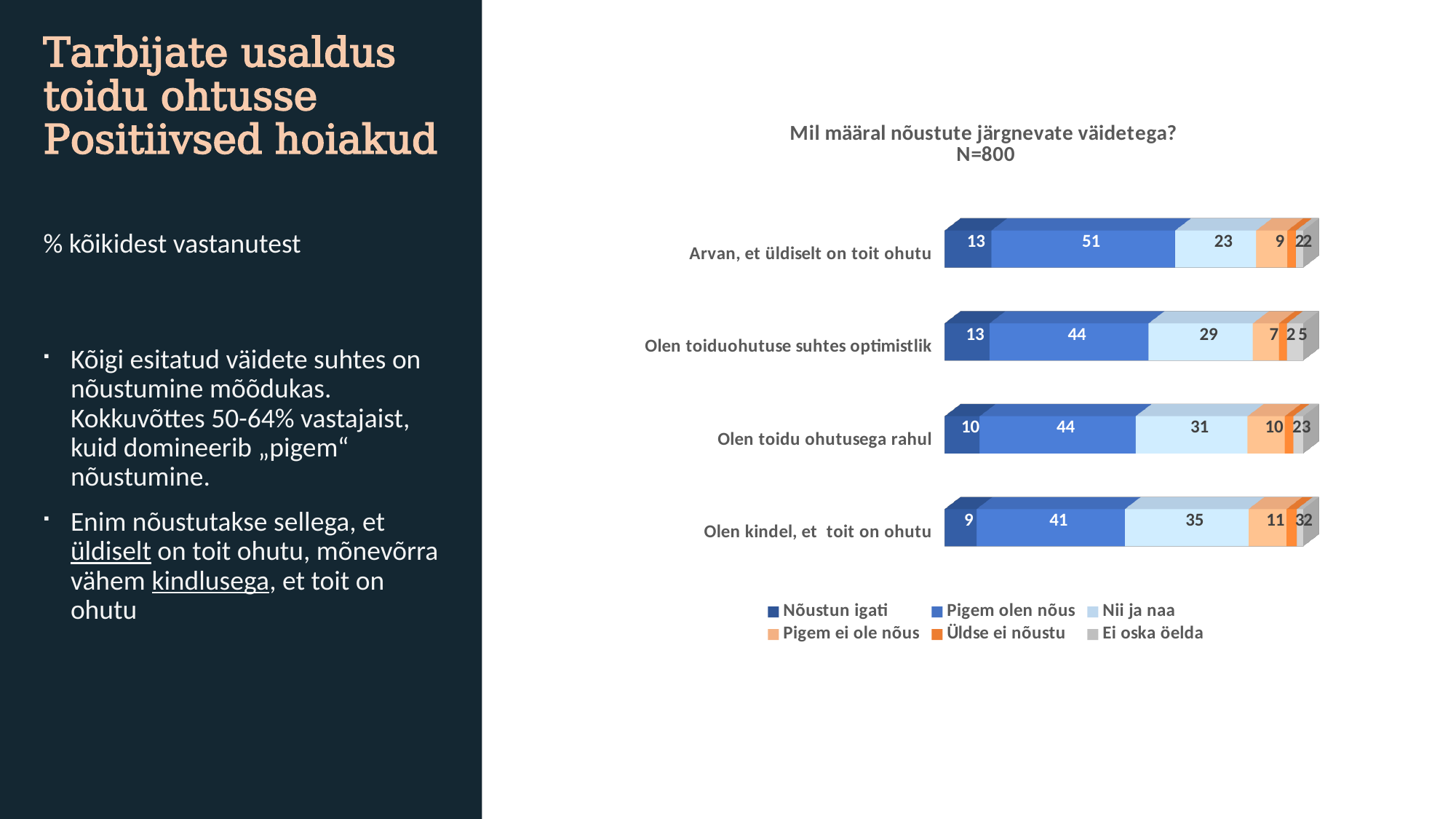
What is the value of "Nii ja naa" for "Olen kindel, et toit on ohutu"? 35 How many statements (categories) are shown in the chart? 4 Which statement has the highest "Pigem olen nõus" value? Arvan, et üldiselt on toit ohutu What kind of chart is shown on the slide? Stacked bar chart What is the value of "Ei oska öelda" for "Olen toiduohutuse suhtes optimistlik"? 5 What is the difference between the "Nii ja naa" values for "Olen kindel, et toit on ohutu" and "Arvan, et üldiselt on toit ohutu"? 12 Which statement has the lowest "Nõustun igati" value? Olen kindel, et toit on ohutu Which is larger: the "Pigem ei ole nõus" value for "Olen kindel, et toit on ohutu" or for "Olen toiduohutuse suhtes optimistlik"? Olen kindel, et toit on ohutu What is the value of "Pigem olen nõus" for "Arvan, et üldiselt on toit ohutu"? 51 What is the value of "Nõustun igati" for "Olen toidu ohutusega rahul"? 10 What is the sample size (N) stated in the chart title? N=800 How many series does the legend list? 6